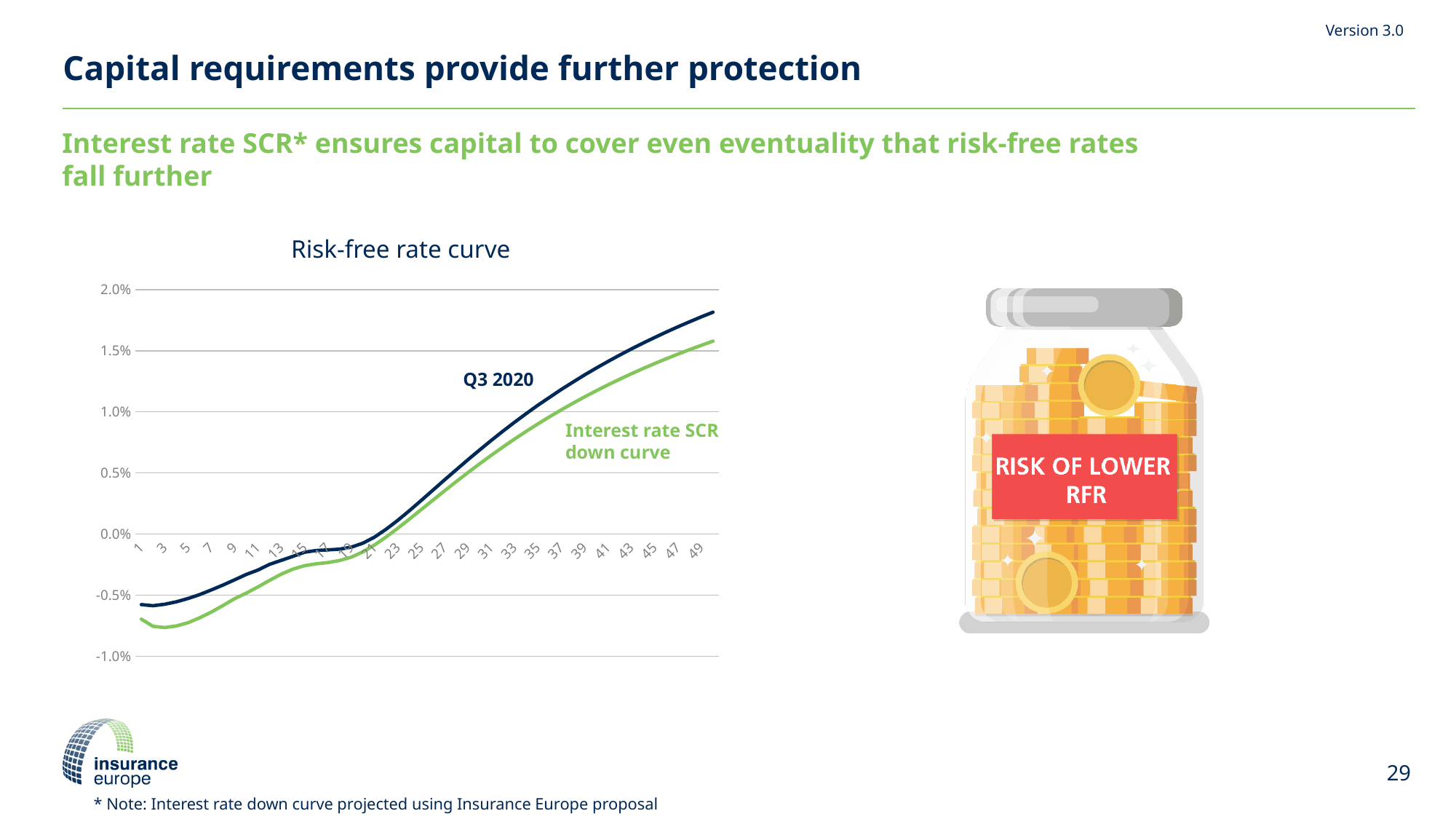
Which series is drawn in green in the Risk-free rate curve chart? Interest rate SCR down curve What is the highest value labelled on the y axis of the chart? 2.0% Do the values of the Q3 2020 curve generally rise or fall as the x axis increases from 1 to 49? Rise What kind of chart is shown on the slide? Line chart Is the value of the Q3 2020 curve at x = 49 greater or less than 1.5%? greater Which series is higher at x = 49, Q3 2020 or Interest rate SCR down curve? Q3 2020 How many series are plotted in the Risk-free rate curve chart? 2 Is the value of the Interest rate SCR down curve at x = 41 greater or less than 1.0%? greater Is the value of the Q3 2020 curve at x = 29 greater or less than 0.5%? greater Which series is lower at x = 1, Q3 2020 or Interest rate SCR down curve? Interest rate SCR down curve What is the title of the chart? Risk-free rate curve